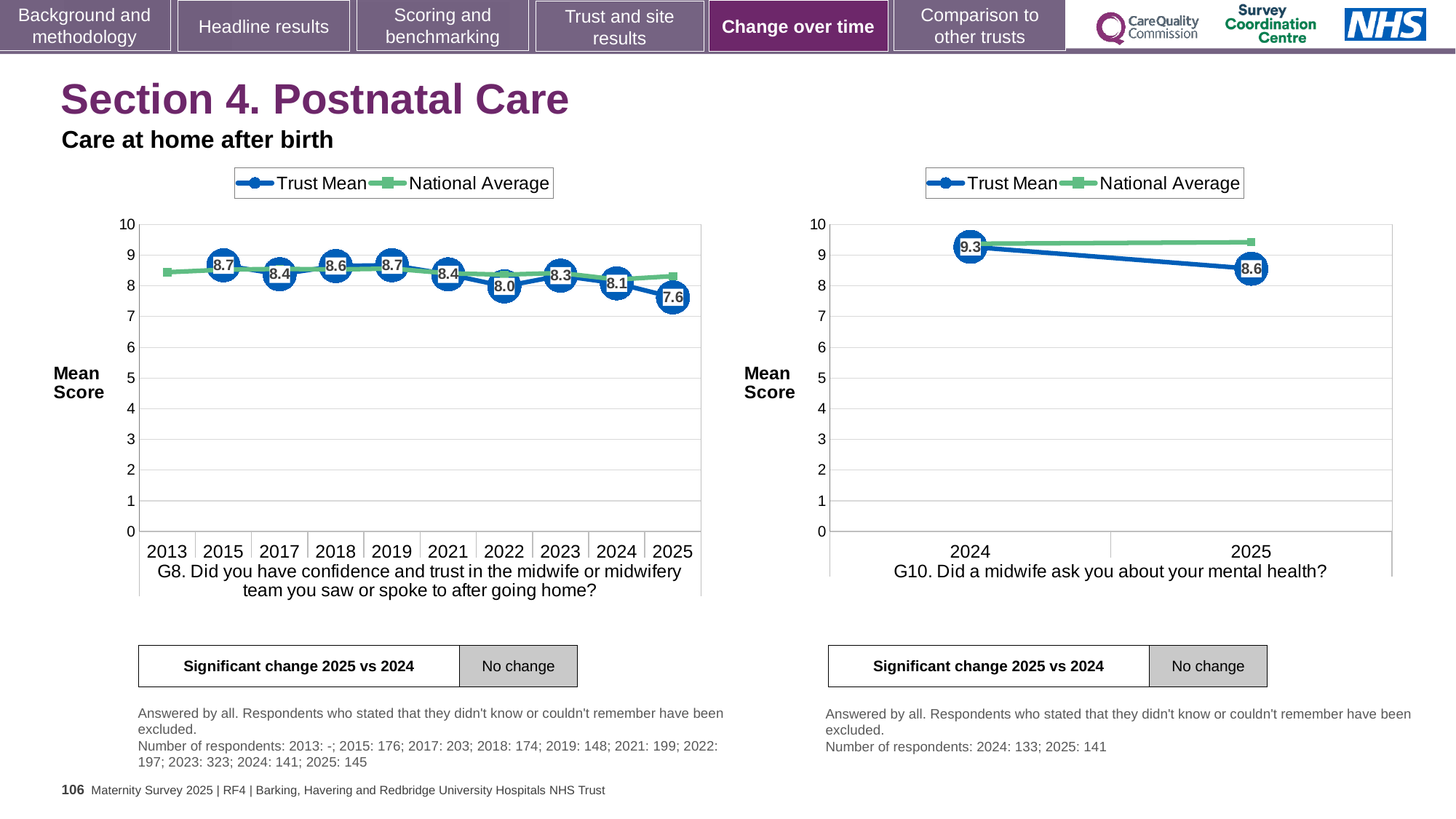
On the G8 chart (left), is the Trust Mean higher in 2019 or in 2022? 2019 How many series does the legend of the G8 chart (left) list? 2 On the G8 chart (left), which year has the lowest Trust Mean? 2025 On the G10 chart (right), is the National Average for 2025 greater or less than 9? greater On the G8 chart (left), what is the Trust Mean for 2022? 8.0 On the G10 chart (right), does the Trust Mean rise or fall from 2024 to 2025? fall On the G8 chart (left), what is the Trust Mean for 2025? 7.6 On the G10 chart (right), by how much did the Trust Mean change from 2024 to 2025? 0.7 On the G10 chart (right), what is the Trust Mean for 2025? 8.6 On the G10 chart (right), what is the Trust Mean for 2024? 9.3 On the G8 chart (left), what is the difference between the Trust Mean in 2024 and 2025? 0.5 On the G8 chart (left), how many years are shown on the x axis? 10